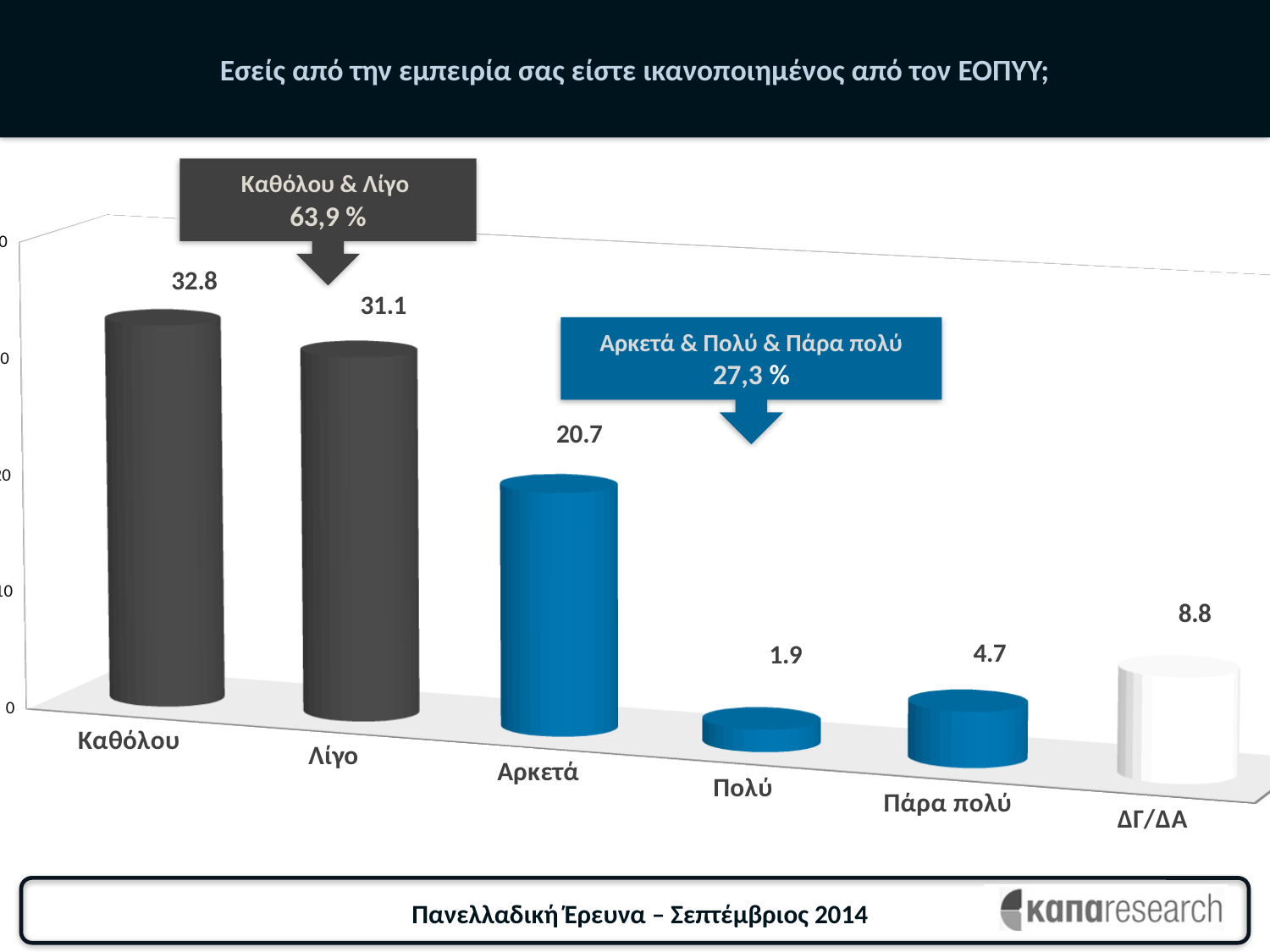
What combined percentage does the callout give for Αρκετά & Πολύ & Πάρα πολύ? 27,3 % What is the difference between the values for Πάρα πολύ and Πολύ? 2.8 Which category has the highest value? Καθόλου What is the value for ΔΓ/ΔΑ? 8.8 What is the difference between the values for Καθόλου and Λίγο? 1.7 How many categories are shown on the x axis? 6 What is the value for Αρκετά? 20.7 What kind of chart is shown on the slide? bar chart What combined percentage does the callout give for Καθόλου & Λίγο? 63,9 % Which category has the lowest value? Πολύ Which is larger, the value for ΔΓ/ΔΑ or the value for Πάρα πολύ? ΔΓ/ΔΑ What is the value for Καθόλου? 32.8